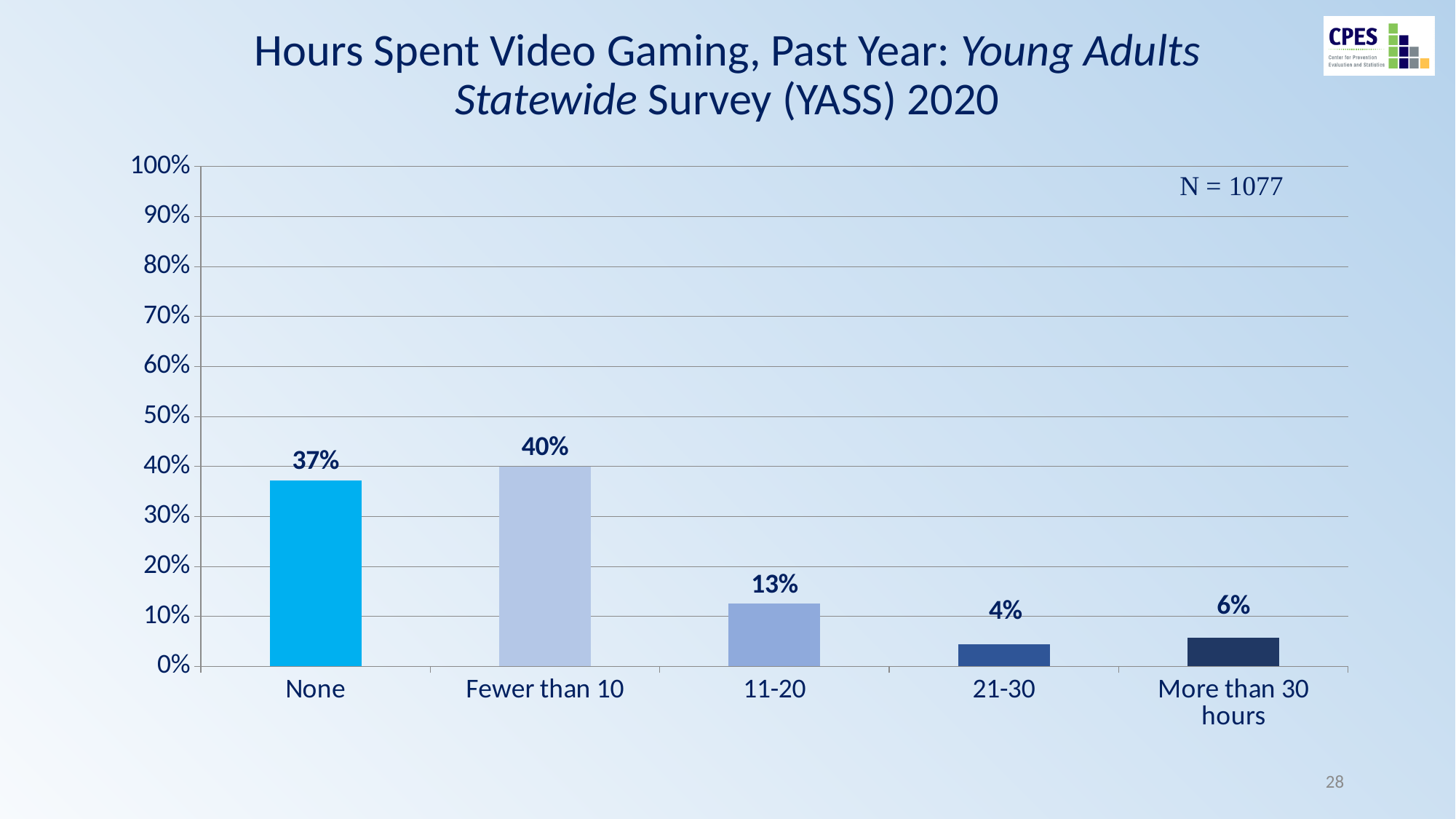
What is the value for the 'Fewer than 10' category? 40% How many categories are shown on the x axis? 5 What sample size (N) is shown on the chart? N = 1077 Which category has the lowest value? 21-30 What is the difference between the 'Fewer than 10' and 'None' values? 3% What kind of chart is shown on the slide? Bar chart What percentage of respondents reported 11-20 hours of video gaming? 13% What is the value shown for the '21-30' category? 4% What percentage reported more than 30 hours of video gaming? 6% Which is larger, the value for '21-30' or the value for 'More than 30 hours'? More than 30 hours What percentage of respondents reported spending no hours video gaming in the past year? 37% Which category has the highest value? Fewer than 10